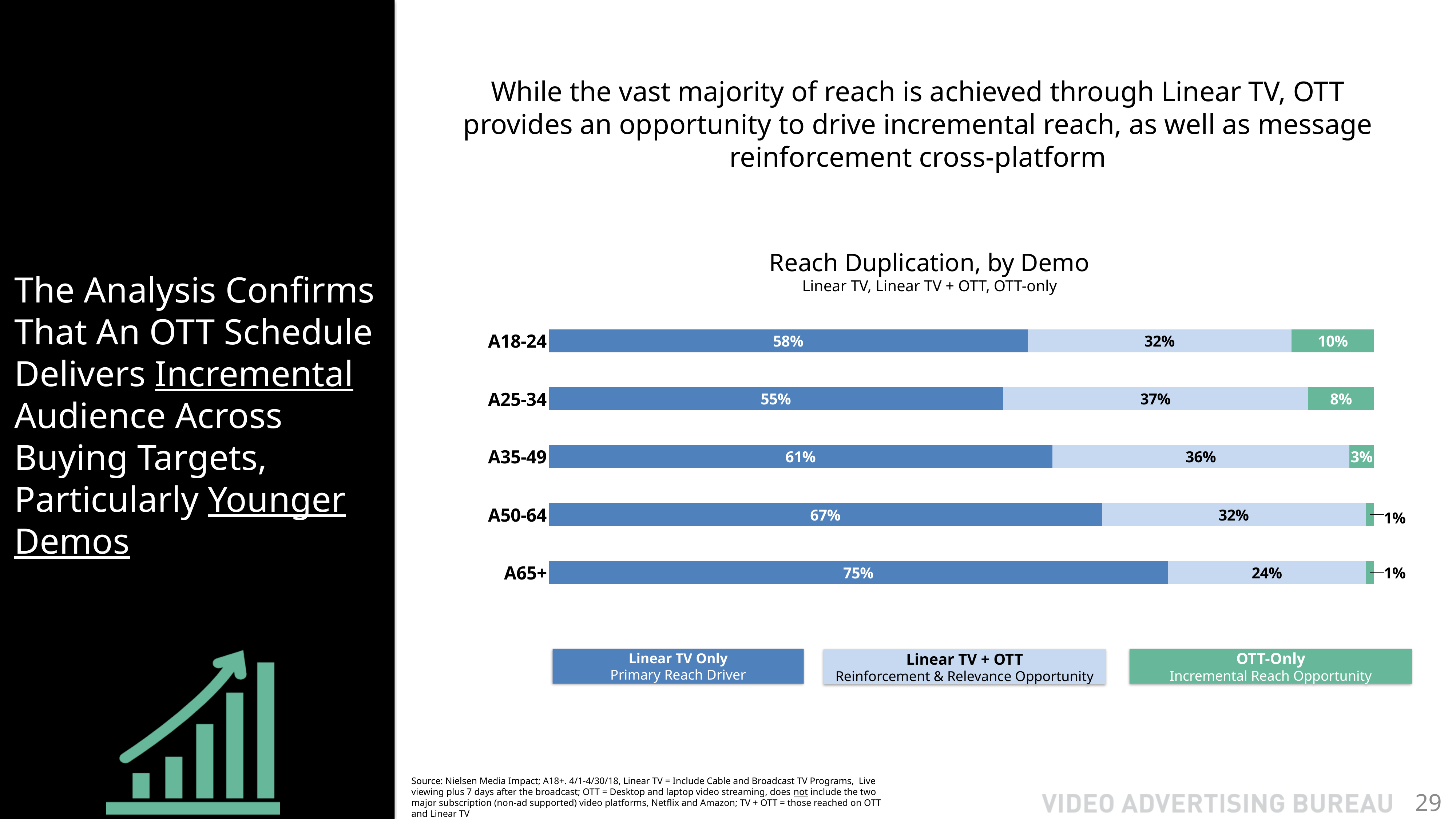
Which demo has the lowest Linear TV + OTT value? A65+ What kind of chart is shown on the slide? Stacked bar chart Which demo has the highest Linear TV Only value? A65+ Which is larger, the Linear TV + OTT value for A25-34 or for A50-64? A25-34 What is the Linear TV Only value for A18-24? 58% How many series does the legend list? 3 How many demo categories are shown in the chart? 5 Which demo has the highest OTT-Only value? A18-24 What is the difference between the Linear TV Only values for A65+ and A18-24? 17% What is the Linear TV + OTT value for A35-49? 36% What is the Linear TV Only value for A65+? 75% What is the OTT-Only value for A25-34? 8%